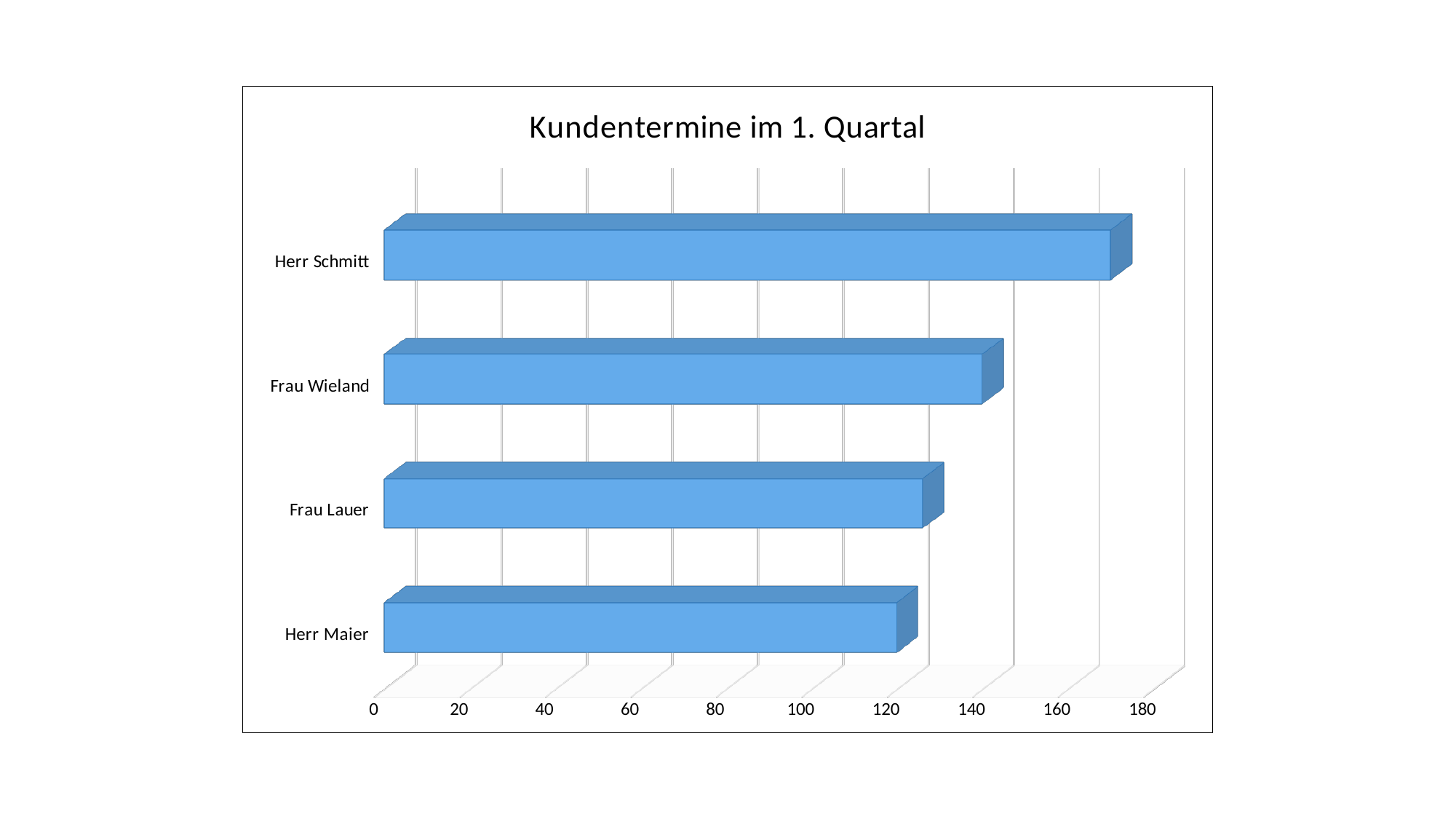
Who has more Kundentermine, Frau Wieland or Frau Lauer? Frau Wieland Is the value for Herr Maier greater or less than 100? greater What kind of chart is shown on the slide? bar chart How many categories (people) are shown in the chart? 4 Is the value for Frau Lauer greater or less than 140? less Is the value for Herr Schmitt greater or less than 160? greater Which person has the lowest number of Kundentermine? Herr Maier Which person has the highest number of Kundentermine? Herr Schmitt Who has more Kundentermine, Herr Schmitt or Frau Wieland? Herr Schmitt What is the title of the chart? Kundentermine im 1. Quartal